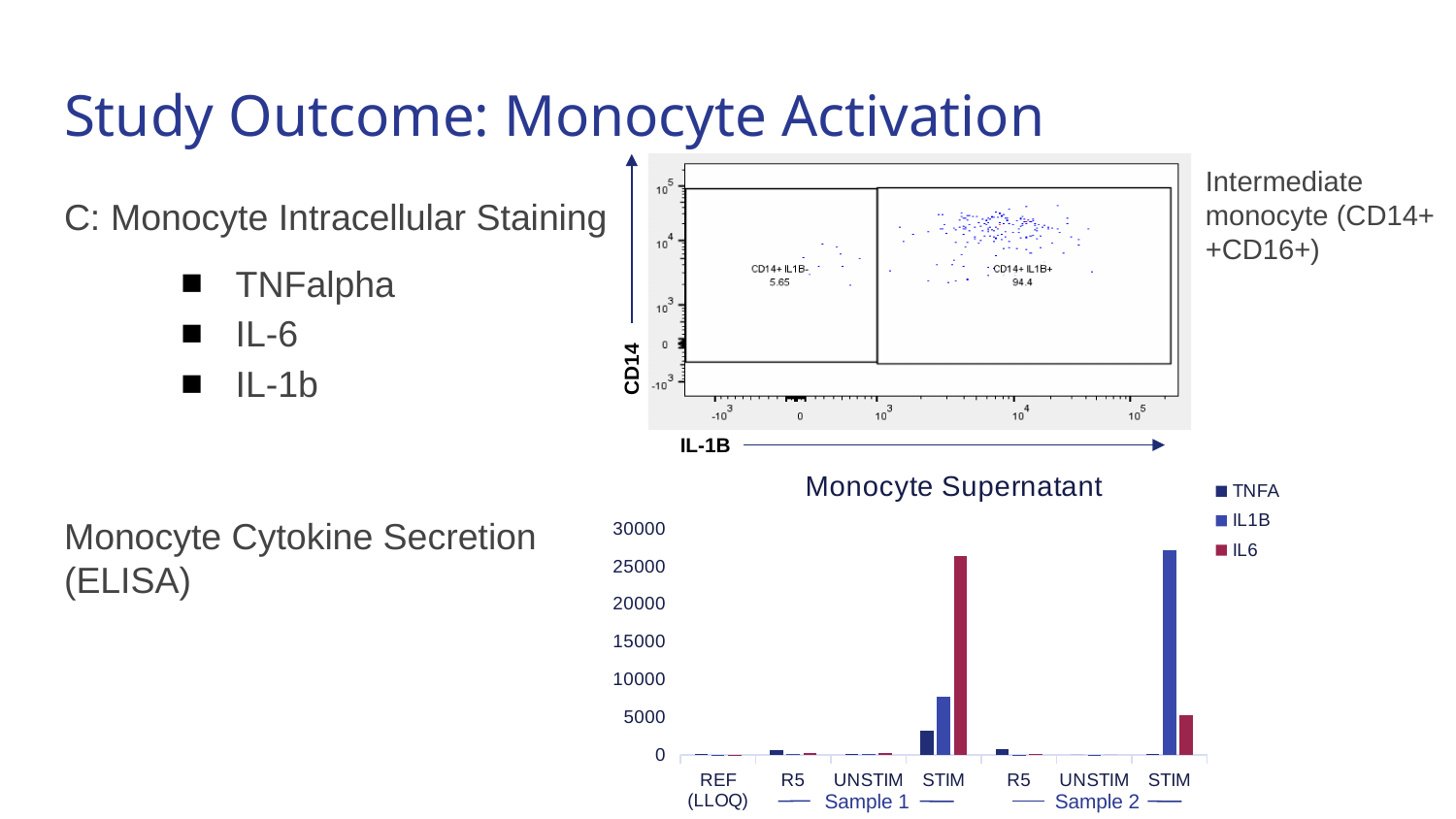
In the flow cytometry scatter plot, what percentage is printed in the CD14+ IL1B- gate? 5.65 In the 'Monocyte Supernatant' chart, is the IL1B value for Sample 2 STIM greater or less than 25000? greater How many categories are shown on the x axis of the 'Monocyte Supernatant' chart? 7 In the 'Monocyte Supernatant' chart, for Sample 2 STIM, which is larger: IL1B or IL6? IL1B In the 'Monocyte Supernatant' chart, is the IL6 value for Sample 1 STIM greater or less than 20000? greater How many series does the legend of the 'Monocyte Supernatant' chart list? 3 In the 'Monocyte Supernatant' chart, which series has the highest value for Sample 2 STIM? IL1B In the 'Monocyte Supernatant' chart, is the TNFA value for Sample 1 STIM greater or less than 5000? less In the flow cytometry scatter plot, what percentage is printed in the CD14+ IL1B+ gate? 94.4 What kind of chart is the 'Monocyte Supernatant' chart? bar chart In the 'Monocyte Supernatant' chart, which series has the highest value for Sample 1 STIM? IL6